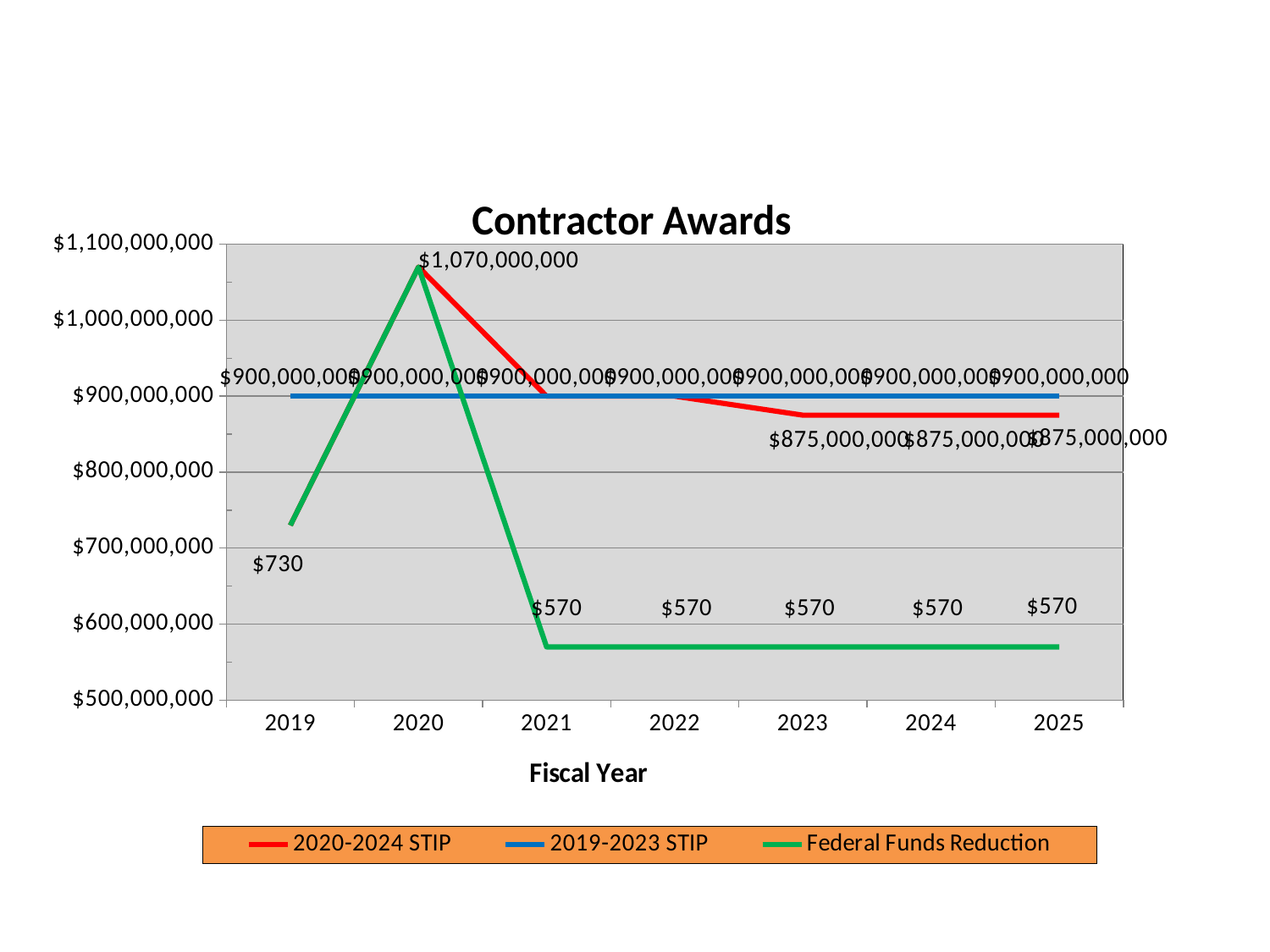
How many series does the legend of the Contractor Awards chart list? 3 What type of chart is shown on the slide? Line chart What is the value of the 2019-2023 STIP series in fiscal year 2022? $900,000,000 Is the Federal Funds Reduction value in fiscal year 2019 greater or less than $800,000,000? less In fiscal year 2025, which series is higher: 2019-2023 STIP or 2020-2024 STIP? 2019-2023 STIP What is the labeled value of the Federal Funds Reduction series in fiscal year 2021? $570 What is the title of the x axis on the Contractor Awards chart? Fiscal Year How many fiscal years are shown on the x axis of the Contractor Awards chart? 7 In fiscal year 2024, how much higher is the 2019-2023 STIP value than the 2020-2024 STIP value? $25,000,000 What is the highest value labeled on the Contractor Awards chart, and in which fiscal year does it occur? $1,070,000,000 in 2020 What is the labeled value of the Federal Funds Reduction series in fiscal year 2019? $730 What is the value of the 2020-2024 STIP series in fiscal year 2023? $875,000,000